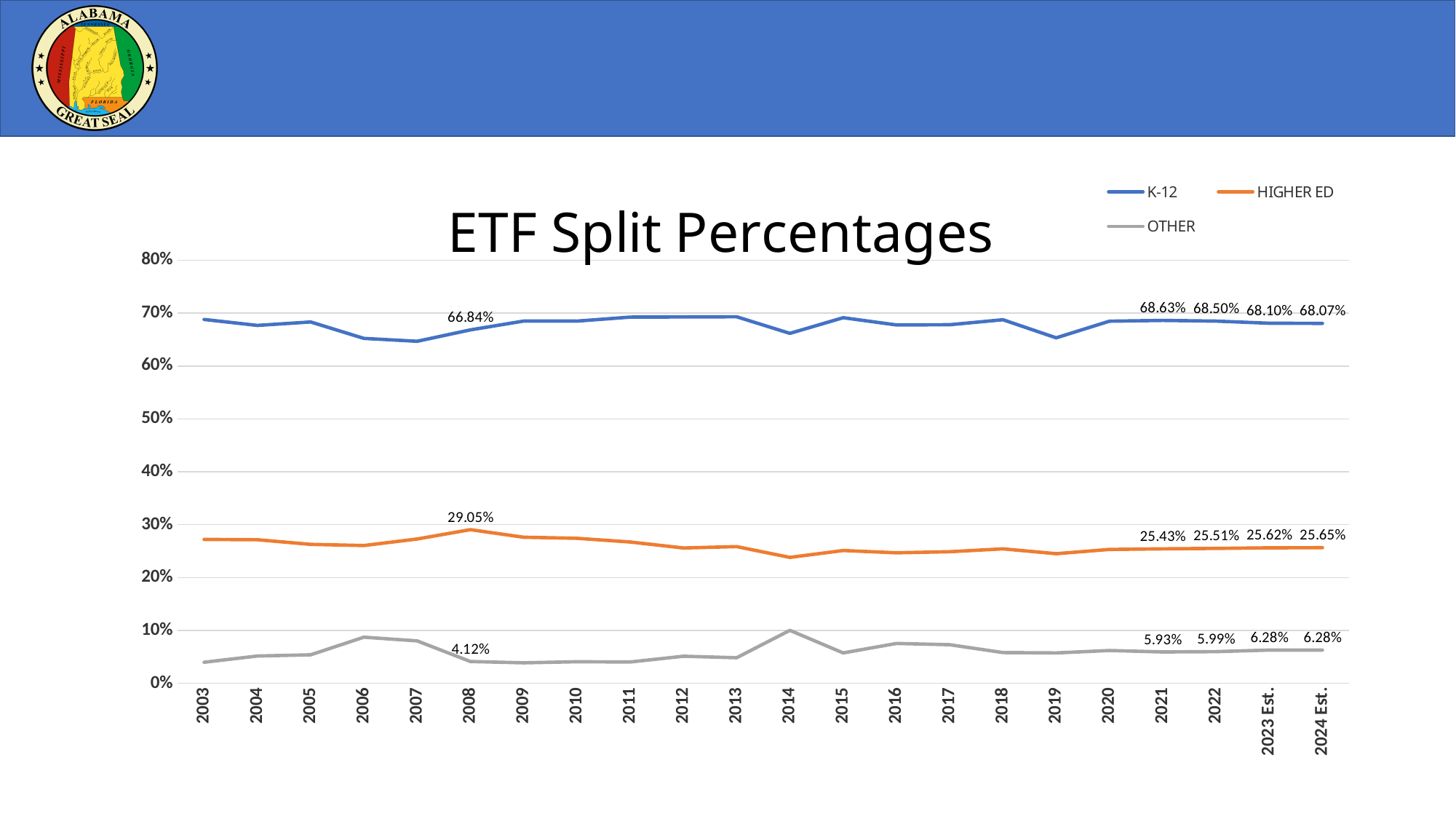
What kind of chart is shown on the slide? line chart Which series has the highest value in 2022? K-12 What is the OTHER value for 2021? 5.93% What is the title of the chart? ETF Split Percentages Does the HIGHER ED line rise or fall from 2021 to 2024 Est.? rise What is the K-12 value for 2024 Est.? 68.07% How many years are shown along the x axis? 22 How many series does the legend list? 3 What is the K-12 value for 2008? 66.84% What is the HIGHER ED value for 2008? 29.05% Is the OTHER value for 2014 greater or less than 20%? less What is the difference between the K-12 values for 2021 and 2024 Est.? 0.56%